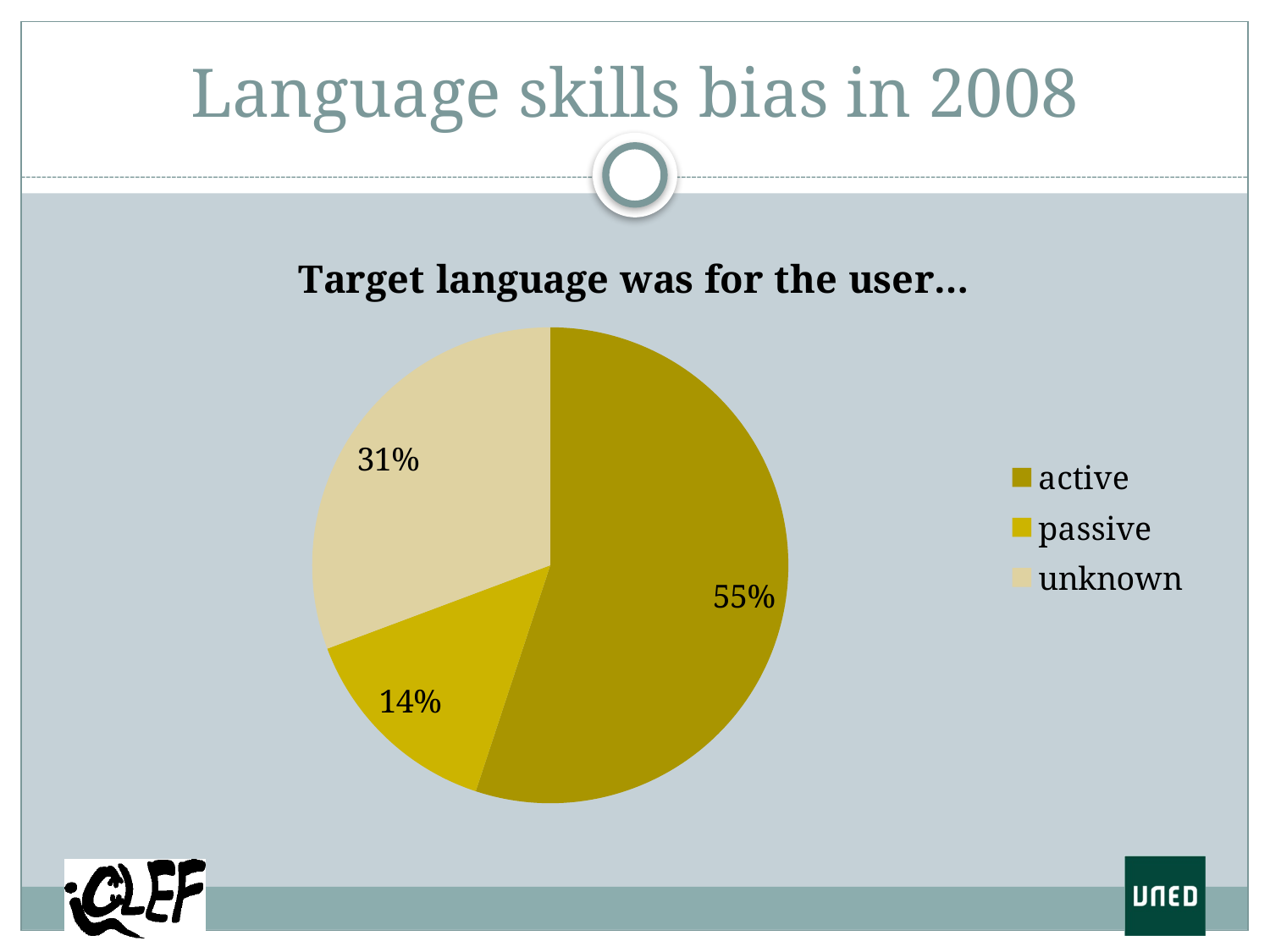
What kind of chart is shown on the slide? pie chart What is the difference in percentage points between the 'active' and 'unknown' slices? 24 What is the combined share of the 'passive' and 'unknown' slices? 45% How many categories does the legend list? 3 Which category has the largest share of the pie? active What is the chart's title? Target language was for the user… What percentage of the pie is labelled 'unknown'? 31% Which category has the smallest share of the pie? passive What percentage of the pie is labelled 'passive'? 14% Which is larger, the 'unknown' slice or the 'passive' slice? unknown Which legend entry is shown in the lightest colour? unknown What percentage of the pie is labelled 'active'? 55%